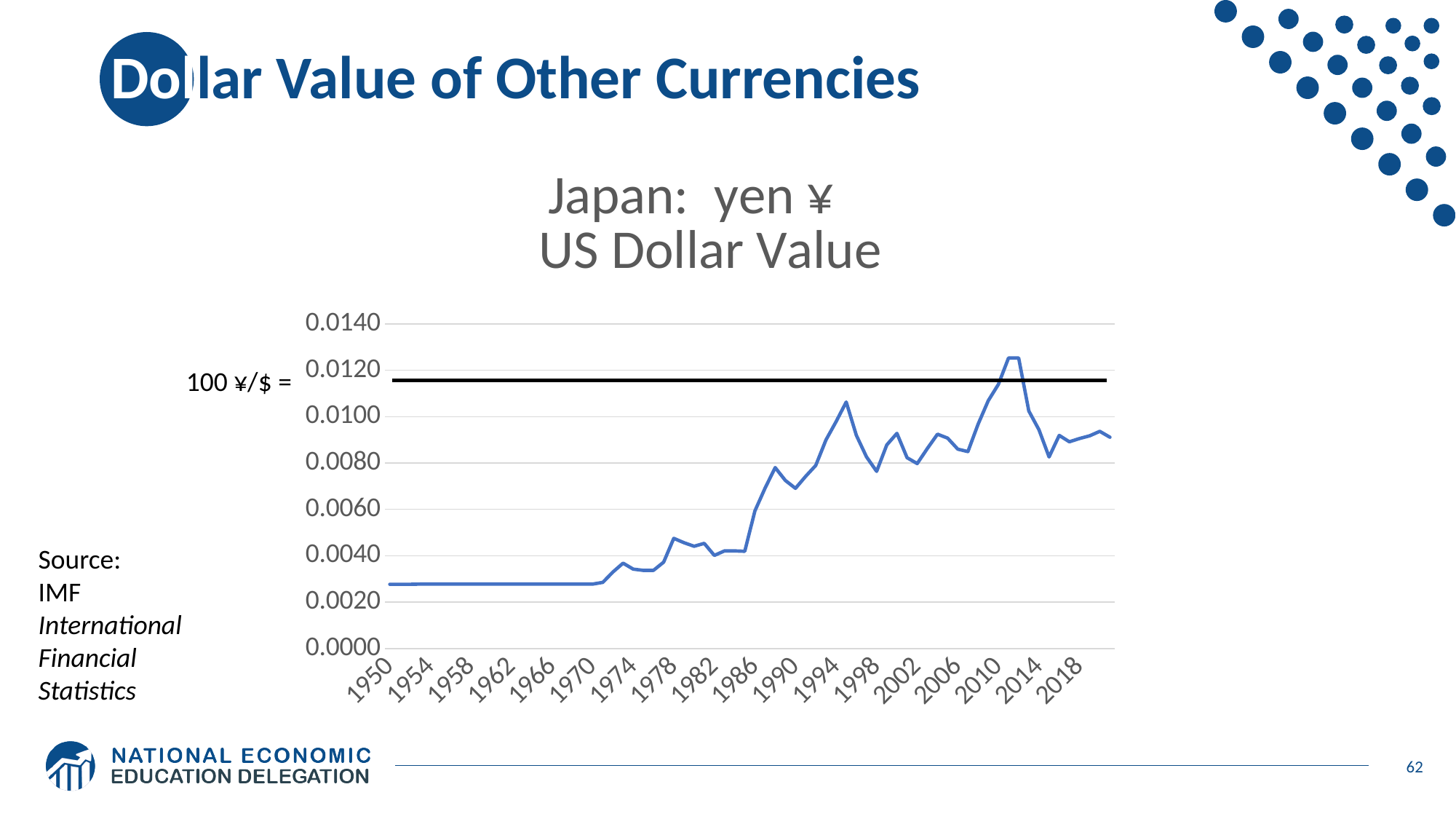
Is the highest point on the line greater or less than 0.0120? greater What label is attached to the horizontal black reference line on the chart? 100 ¥/$ = Is the value for 1970 greater or less than 0.0040? less Is the value for 1950 greater or less than 0.0040? less What is the title of the chart? Japan: yen ¥ US Dollar Value Overall, does the US dollar value of the yen rise or fall from 1950 to 2018? rise How many year labels are shown on the x axis? 18 Which year has the larger value, 1986 or 1990? 1990 Which year has the larger value, 1994 or 1998? 1994 What kind of chart is shown on the slide? line chart